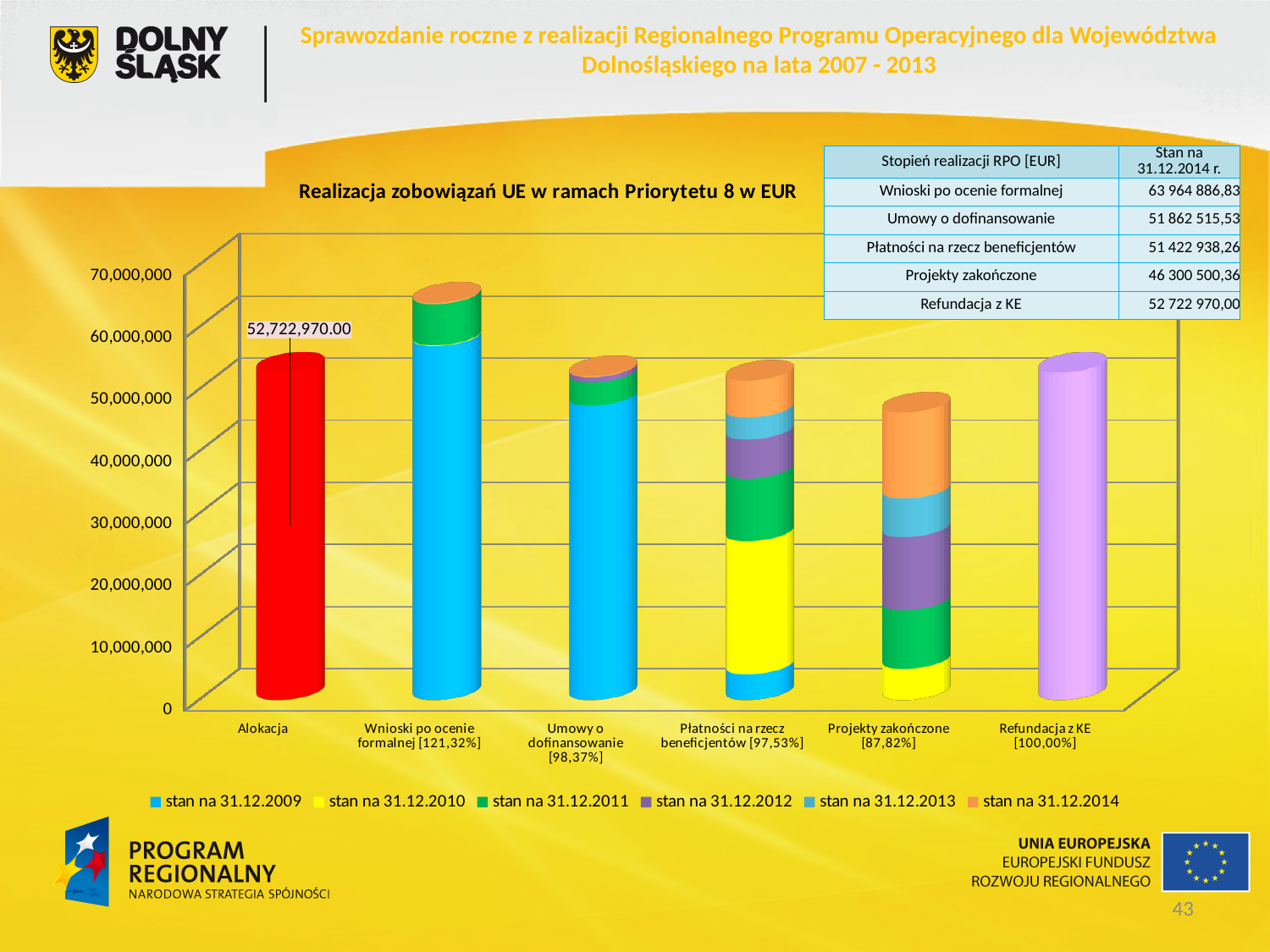
Is the value for Refundacja z KE greater or less than 40,000,000? greater Which bar is taller: Wnioski po ocenie formalnej or Projekty zakończone? Wnioski po ocenie formalnej Is the total value for Projekty zakończone greater or less than 50,000,000? less What kind of chart is shown on the slide? bar chart What is the title of the chart? Realizacja zobowiązań UE w ramach Priorytetu 8 w EUR What colour is the Alokacja bar? red What value is labelled on the Alokacja bar? 52,722,970.00 Which category has the tallest bar? Wnioski po ocenie formalnej [121,32%] Which category has the shortest bar? Projekty zakończone [87,82%] How many categories are shown on the x axis? 6 Is the total value for Wnioski po ocenie formalnej greater or less than 60,000,000? greater How many series does the legend list? 6